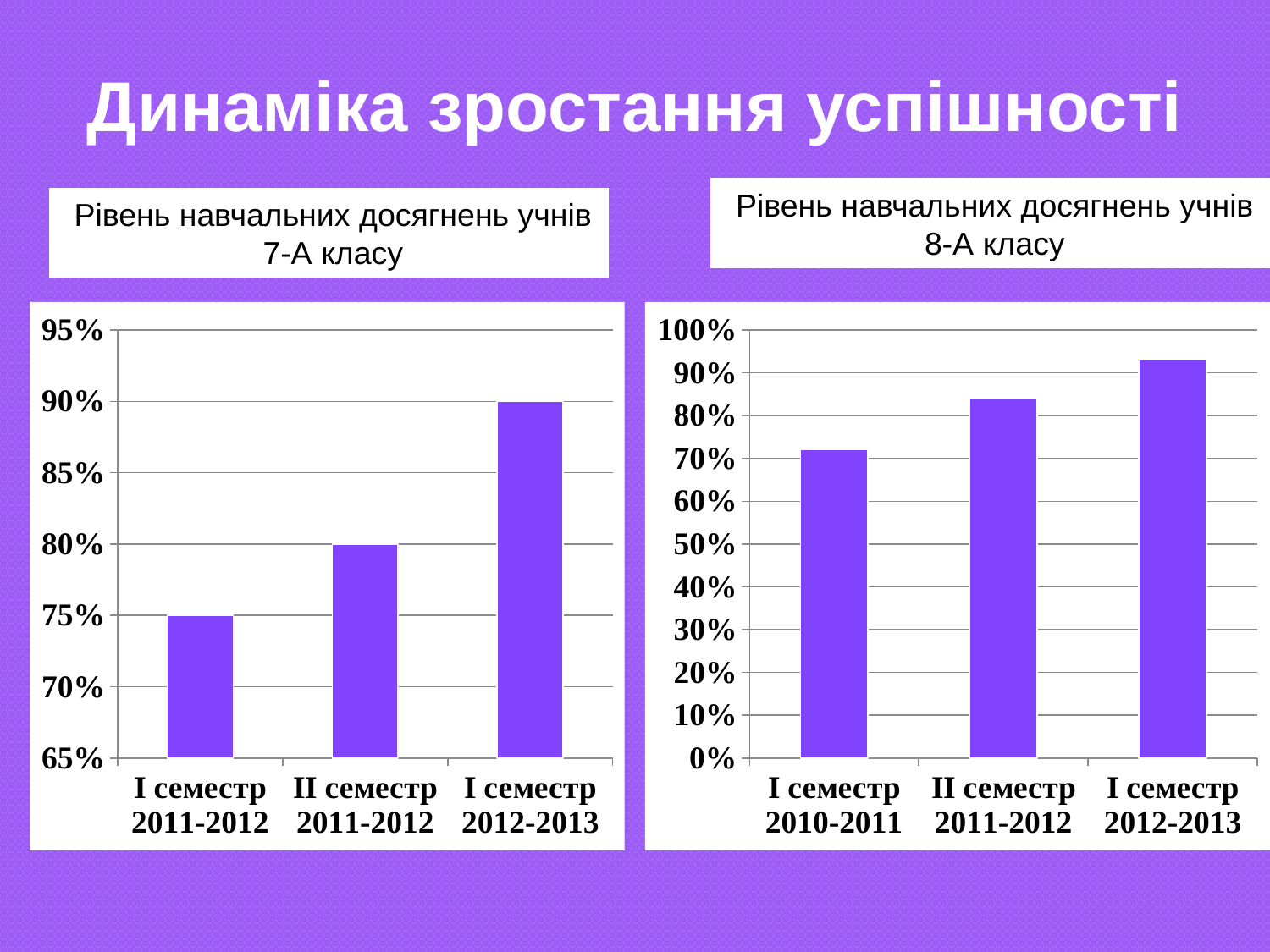
On the right chart (8-A class), which is larger: II семестр 2011-2012 or I семестр 2010-2011? II семестр 2011-2012 On the left chart (7-A class), what is the value for I семестр 2011-2012? 75% On the right chart (8-A class), is the value for I семестр 2010-2011 greater or less than 80%? less On the left chart (7-A class), which semester has the highest value? I семестр 2012-2013 On the right chart (8-A class), do the values rise or fall from left to right? rise On the right chart (8-A class), is the value for I семестр 2012-2013 greater or less than 90%? greater On the right chart (8-A class), which semester has the lowest value? I семестр 2010-2011 On the left chart (7-A class), what is the value for I семестр 2012-2013? 90% How many bars are shown on the right chart (8-A class)? 3 What type of chart is the left chart (7-A class)? bar chart On the left chart (7-A class), what is the difference between I семестр 2012-2013 and I семестр 2011-2012? 15% On the left chart (7-A class), what is the value for II семестр 2011-2012? 80%